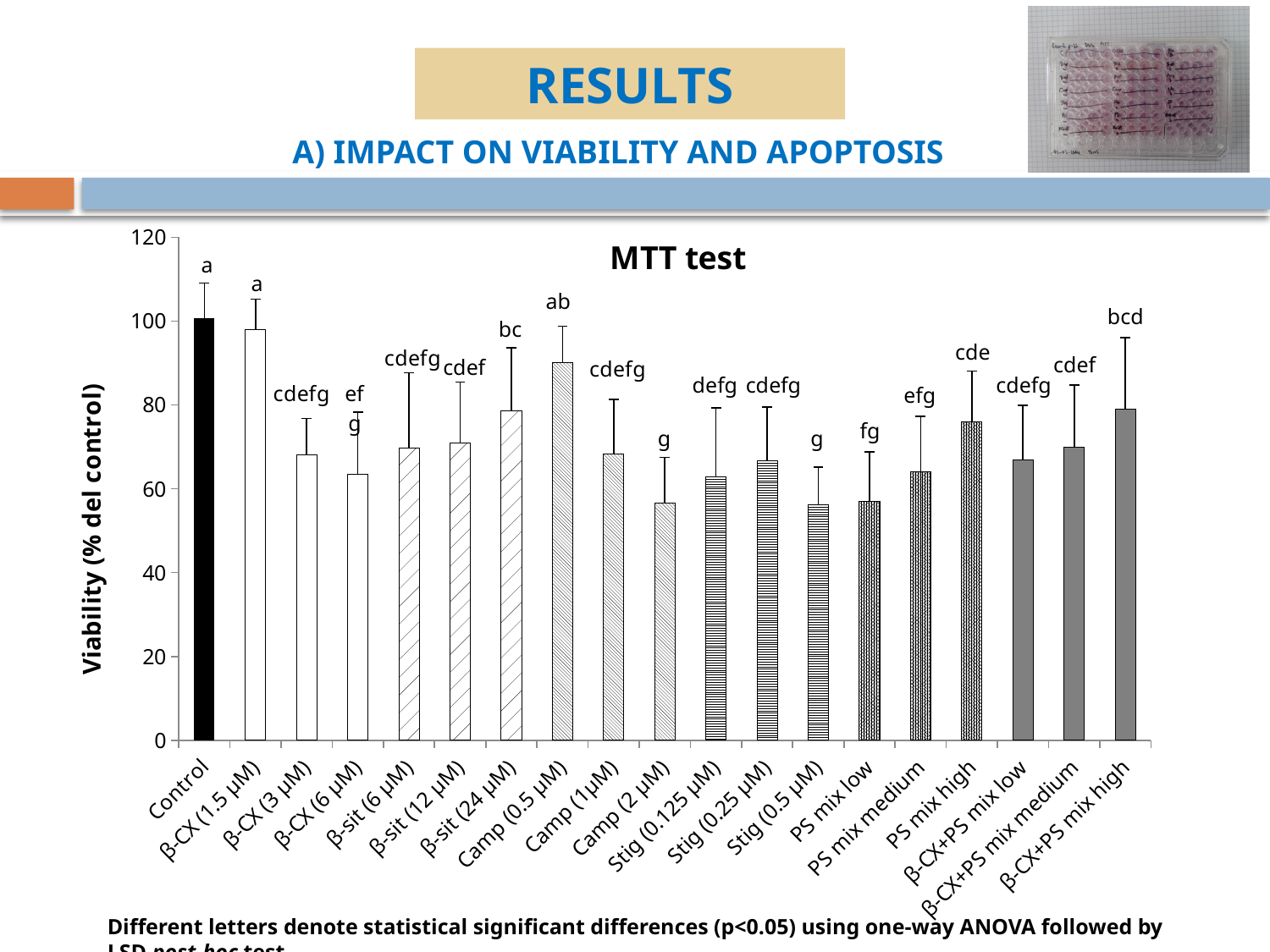
What type of chart is shown on the slide? bar chart Which has the higher viability, Control or Camp (2 µM)? Control What statistical letter label is printed above the Camp (0.5 µM) bar? ab What is the label of the y-axis? Viability (% del control) How many bars (categories) are plotted in the MTT test chart? 19 What is the title of the chart? MTT test Is the viability value for Camp (0.5 µM) greater or less than 80? greater Is the viability value for Control greater or less than 80? greater Is the viability value for β-CX (6 µM) greater or less than 80? less Which has the higher viability, Camp (0.5 µM) or Camp (1µM)? Camp (0.5 µM)